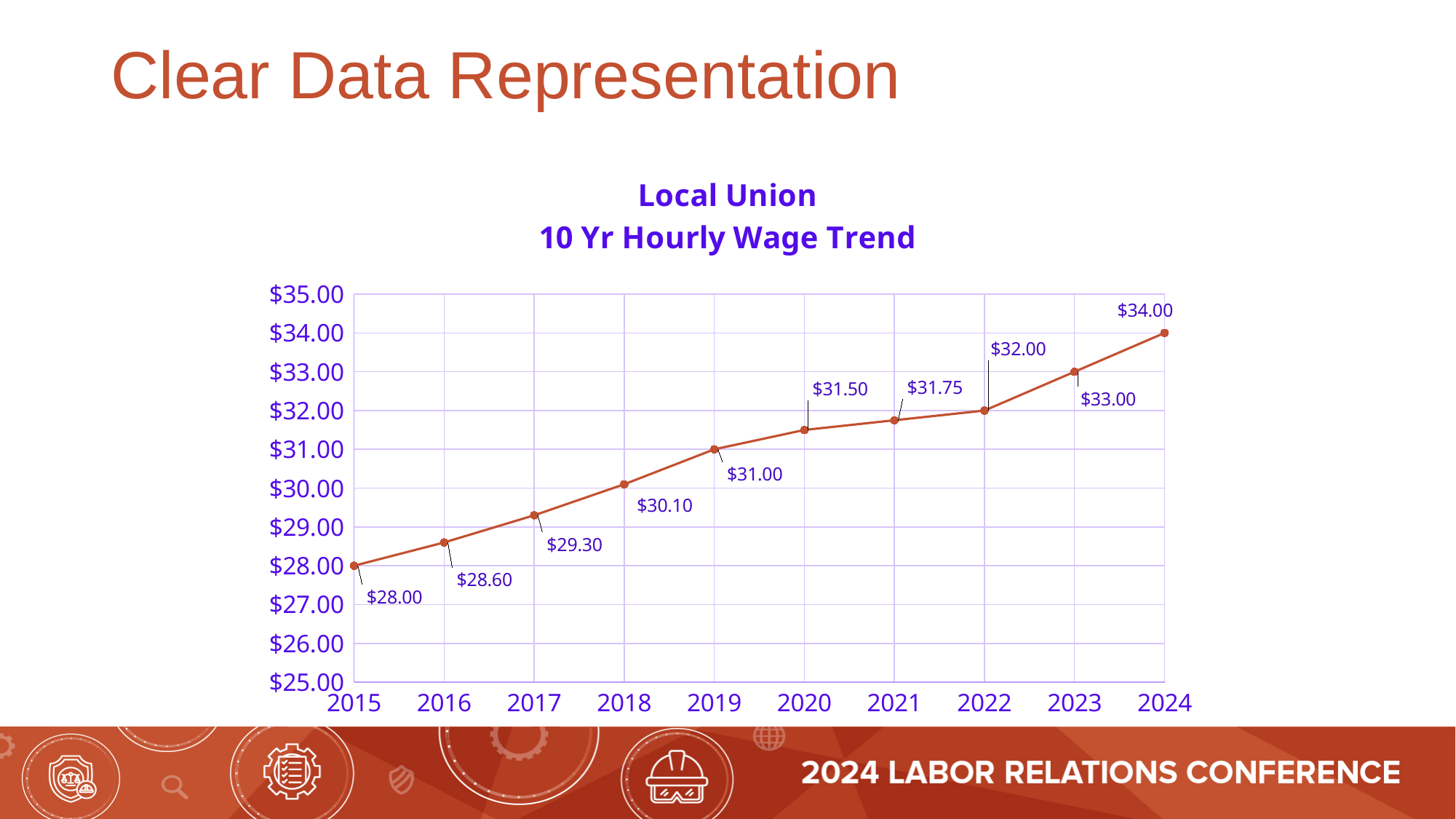
What kind of chart is shown on the slide? Line chart What is the hourly wage value for 2024? $34.00 What is the hourly wage value for 2018? $30.10 What is the hourly wage value for 2021? $31.75 Which is larger, the hourly wage in 2017 or in 2019? 2019 Which year has the lowest hourly wage? 2015 Which year has the highest hourly wage? 2024 What is the difference between the hourly wage in 2024 and in 2015? $6.00 Do the hourly wage values rise or fall from 2015 to 2024? Rise What is the hourly wage value for 2015? $28.00 What is the difference between the hourly wage in 2020 and in 2019? $0.50 How many years are plotted on the chart? 10